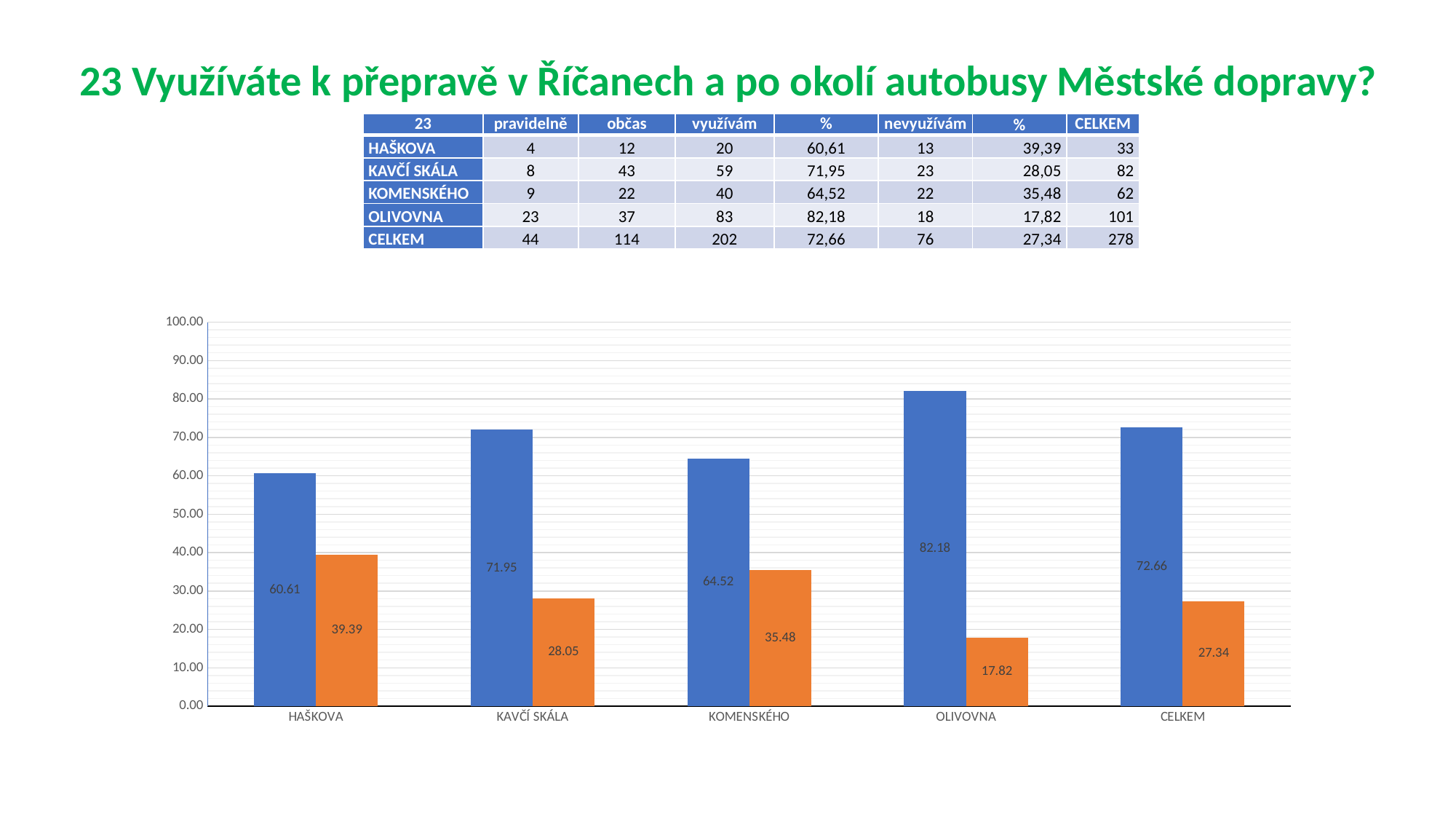
What kind of chart is shown on the slide? Bar chart What is the value of the orange bar for CELKEM? 27.34 Which category has the highest blue bar? OLIVOVNA Which category has the lowest blue bar? HAŠKOVA Which is larger, the blue bar for KAVČÍ SKÁLA or the blue bar for CELKEM? CELKEM What is the value of the orange bar for HAŠKOVA? 39.39 What is the difference between the blue bar and the orange bar for KOMENSKÉHO? 29.04 How many categories are shown on the x axis of the chart? 5 Which category has the lowest orange bar? OLIVOVNA What is the total of the blue and orange bars for HAŠKOVA? 100.00 What is the value of the blue bar for KAVČÍ SKÁLA? 71.95 What is the value of the blue bar for OLIVOVNA? 82.18